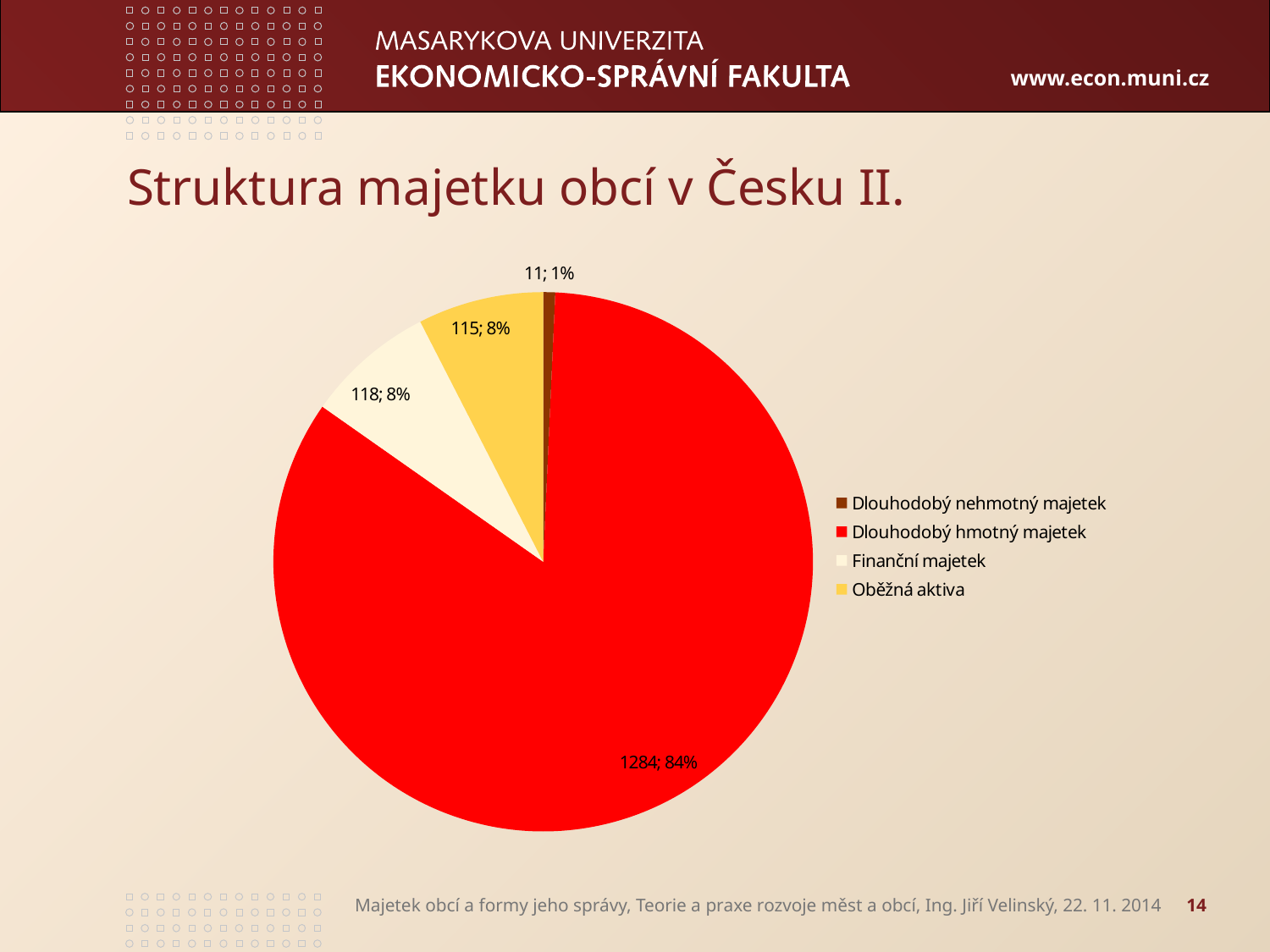
What is the difference between the values for Finanční majetek and Oběžná aktiva in the pie chart? 3 What kind of chart is shown on the slide? pie chart What share of the pie does Dlouhodobý nehmotný majetek represent? 1% What value is shown for Dlouhodobý hmotný majetek in the pie chart? 1284 How many slices does the pie chart have? 4 What value is shown for Finanční majetek in the pie chart? 118 What value is shown for Oběžná aktiva in the pie chart? 115 What share of the pie does Dlouhodobý hmotný majetek represent? 84% How many entries does the legend of the pie chart list? 4 Which category has the smallest slice in the pie chart? Dlouhodobý nehmotný majetek Which category has the largest slice in the pie chart? Dlouhodobý hmotný majetek What value is shown for Dlouhodobý nehmotný majetek in the pie chart? 11